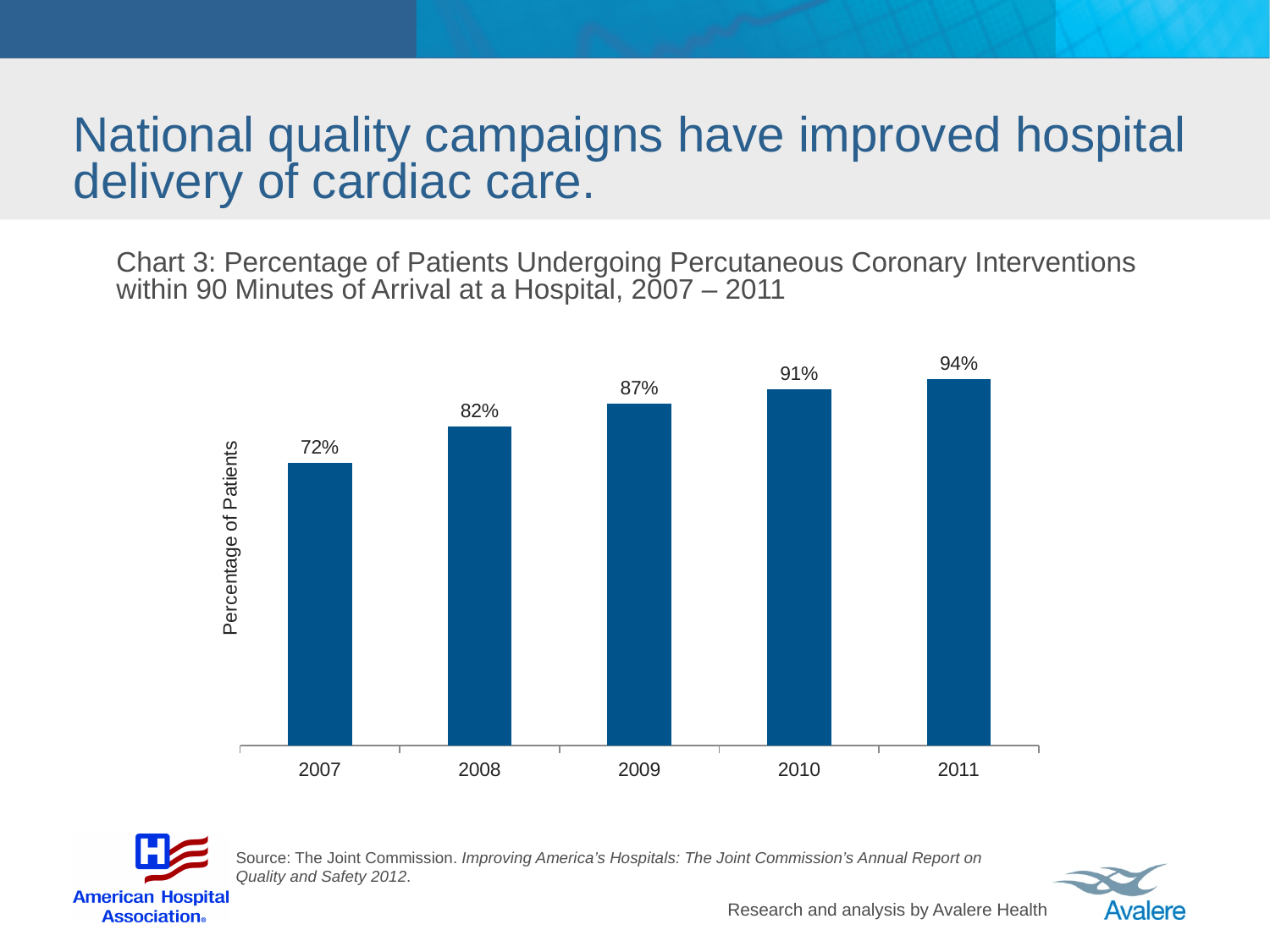
What is the label on the vertical axis of the chart? Percentage of Patients What percentage of patients underwent percutaneous coronary interventions within 90 minutes of arrival in 2007? 72% Which year has the highest percentage of patients? 2011 Do the values rise or fall from 2007 to 2011? Rise By how many percentage points did the value increase from 2007 to 2011? 22 percentage points What is the value shown for 2011? 94% Which year has a larger value, 2008 or 2009? 2009 How many years are shown on the x axis of the chart? 5 What is the value shown for 2009? 87% What kind of chart is shown on the slide? Bar chart What is the difference between the values for 2008 and 2010? 9 percentage points Which year has the lowest percentage of patients? 2007